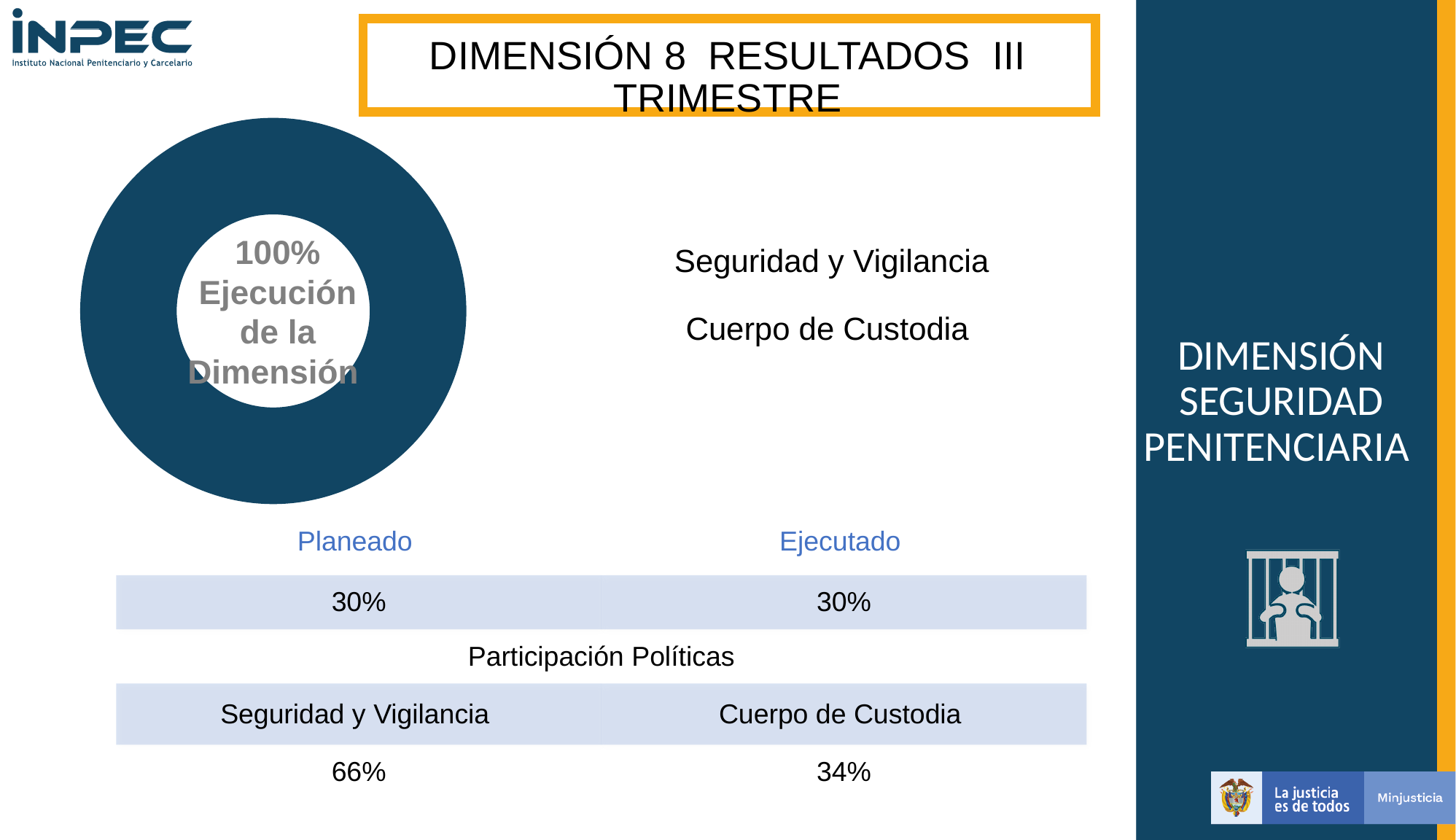
What colour is the ring of the doughnut chart? dark blue How many distinct slices does the doughnut chart show? 1 What kind of chart is shown on the left of the slide? doughnut chart What text accompanies the percentage in the centre of the doughnut chart? Ejecución de la Dimensión What share of the doughnut chart does the single slice occupy? 100% What percentage is printed in the centre of the doughnut chart? 100%